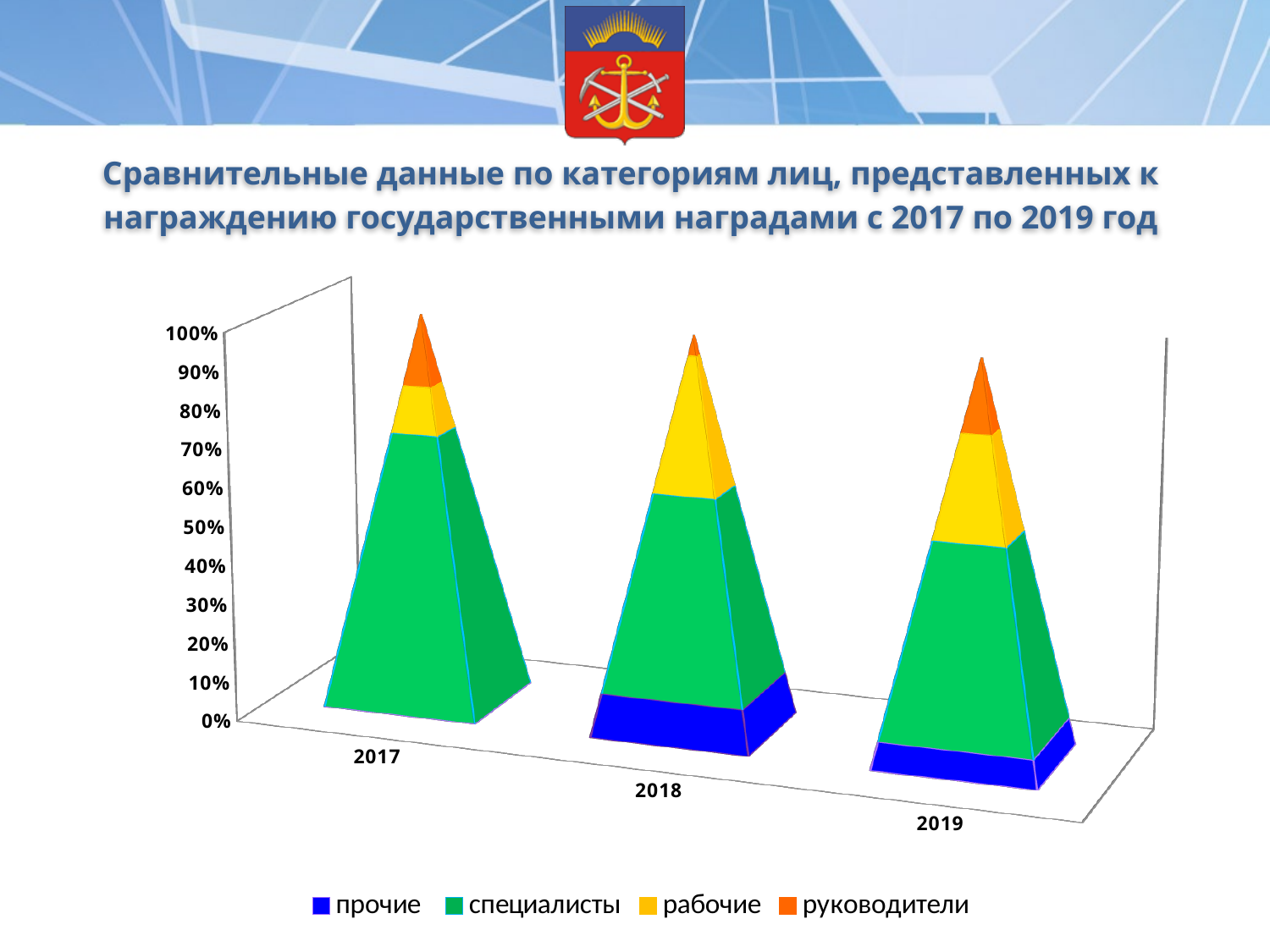
Which year has the larger share of прочие, 2018 or 2019? 2018 Is the share of рабочие in 2018 greater or less than 20%? greater Which year has the larger share of руководители, 2018 or 2019? 2019 What kind of chart is shown on the slide? stacked bar chart Is the share of руководители in 2018 greater or less than 10%? less How many years (categories) are shown on the x axis of the chart? 3 Is the share of специалисты in 2019 greater or less than 40%? greater Which series is shown in blue in the chart? прочие Which series is shown in green in the chart? специалисты Which year has the larger share of рабочие, 2017 or 2018? 2018 How many series does the chart legend list? 4